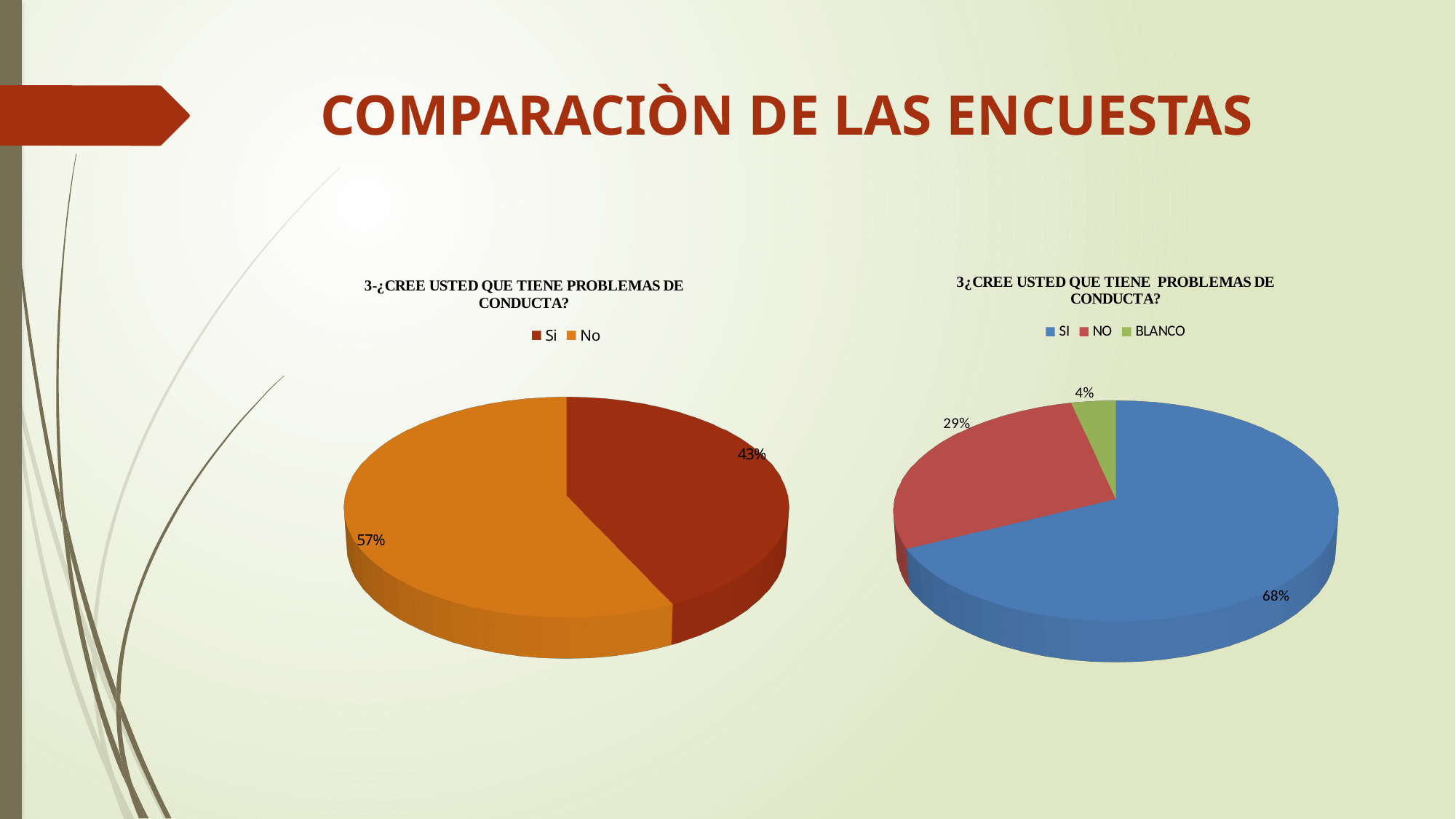
In the right pie chart, what percentage of respondents answered NO? 29% In the left pie chart, which category has the largest share? No Which is larger: the Si share in the left pie chart or the SI share in the right pie chart? SI in the right pie chart In the left pie chart, what percentage of respondents answered Si? 43% In the right pie chart, what is the difference between the SI and NO percentages? 39% What type of chart is used on the left side of the slide? Pie chart In the left pie chart, what percentage of respondents answered No? 57% In the left pie chart, what is the difference between the No and Si percentages? 14% In the right pie chart, what percentage is labelled BLANCO? 4% In the right pie chart, what percentage of respondents answered SI? 68% In the right pie chart, which category has the smallest share? BLANCO How many categories does the legend of the right pie chart list? 3